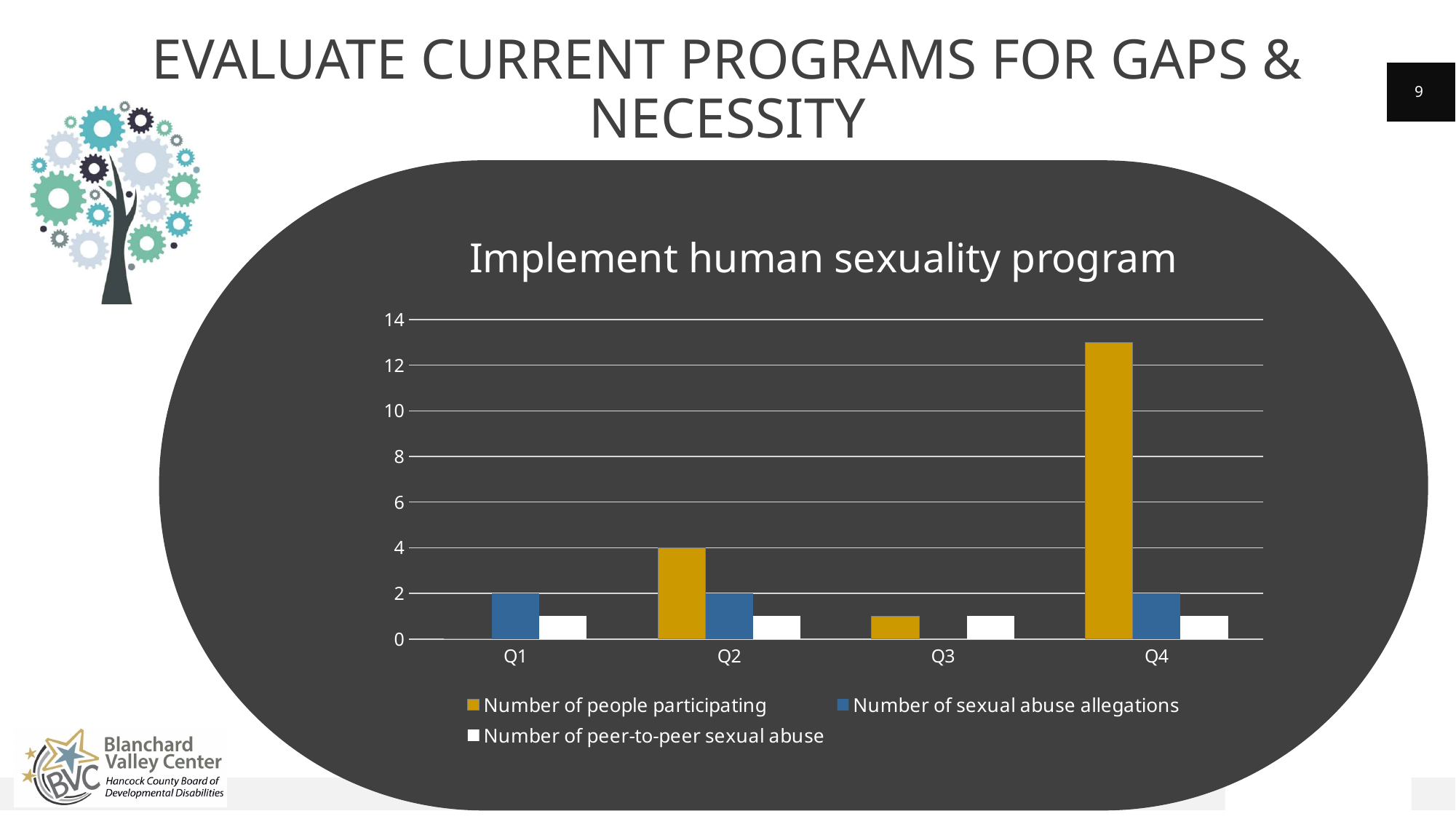
What is the number of people participating in Q2? 4 Is the number of peer-to-peer sexual abuse in Q3 greater or less than 2? less What kind of chart is shown on the slide? Bar chart What is the title of the chart? Implement human sexuality program In Q2, which is larger: the number of people participating or the number of sexual abuse allegations? Number of people participating What is the number of sexual abuse allegations in Q1? 2 Is the number of people participating in Q4 greater or less than 12? greater In Q2, what is the difference between the number of people participating and the number of sexual abuse allegations? 2 Which colour represents the 'Number of people participating' series in the chart? Gold How many series does the chart's legend list? 3 In which quarter is the number of people participating highest? Q4 How many quarters are shown on the x axis of the chart? 4